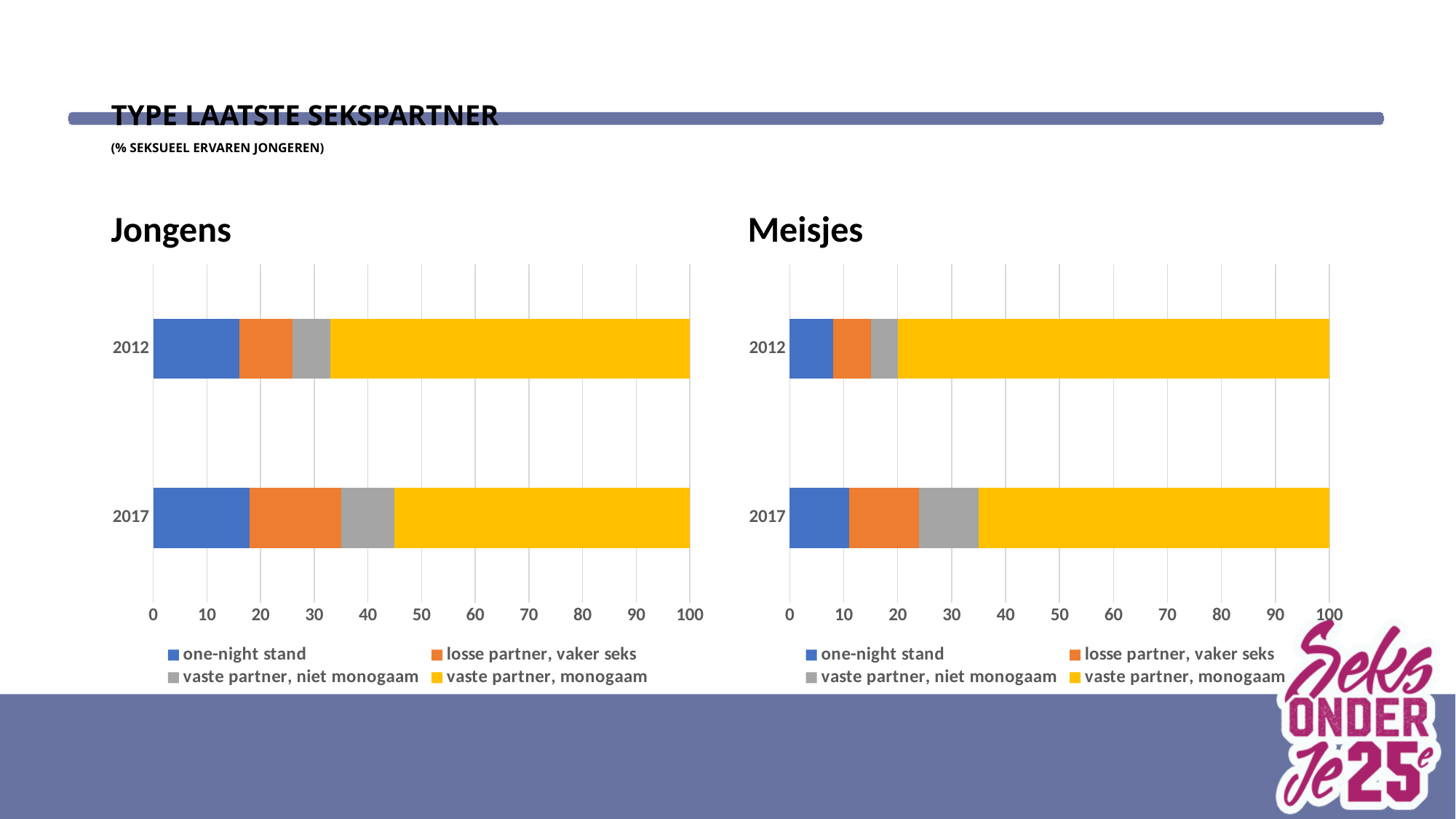
In the Meisjes chart, which series has the largest segment in 2017? vaste partner, monogaam What kind of chart is the Jongens chart? bar chart In the Meisjes chart, which year has the larger one-night stand segment, 2012 or 2017? 2017 How many years are shown on the Jongens chart? 2 In the Jongens chart, does the vaste partner, monogaam segment rise or fall from 2012 to 2017? fall In the Jongens chart, what is the total of the stacked bar for 2017? 100 In the Jongens chart, is the value for one-night stand in 2012 greater or less than 20? less How many series does the legend of the Meisjes chart list? 4 In the legend of the Jongens chart, what colour represents vaste partner, monogaam? yellow In the Jongens chart, is the value for losse partner, vaker seks in 2017 greater or less than 10? greater For 2012, which chart shows the larger one-night stand segment, Jongens or Meisjes? Jongens In the Meisjes chart, is the value for vaste partner, monogaam in 2012 greater or less than 70? greater